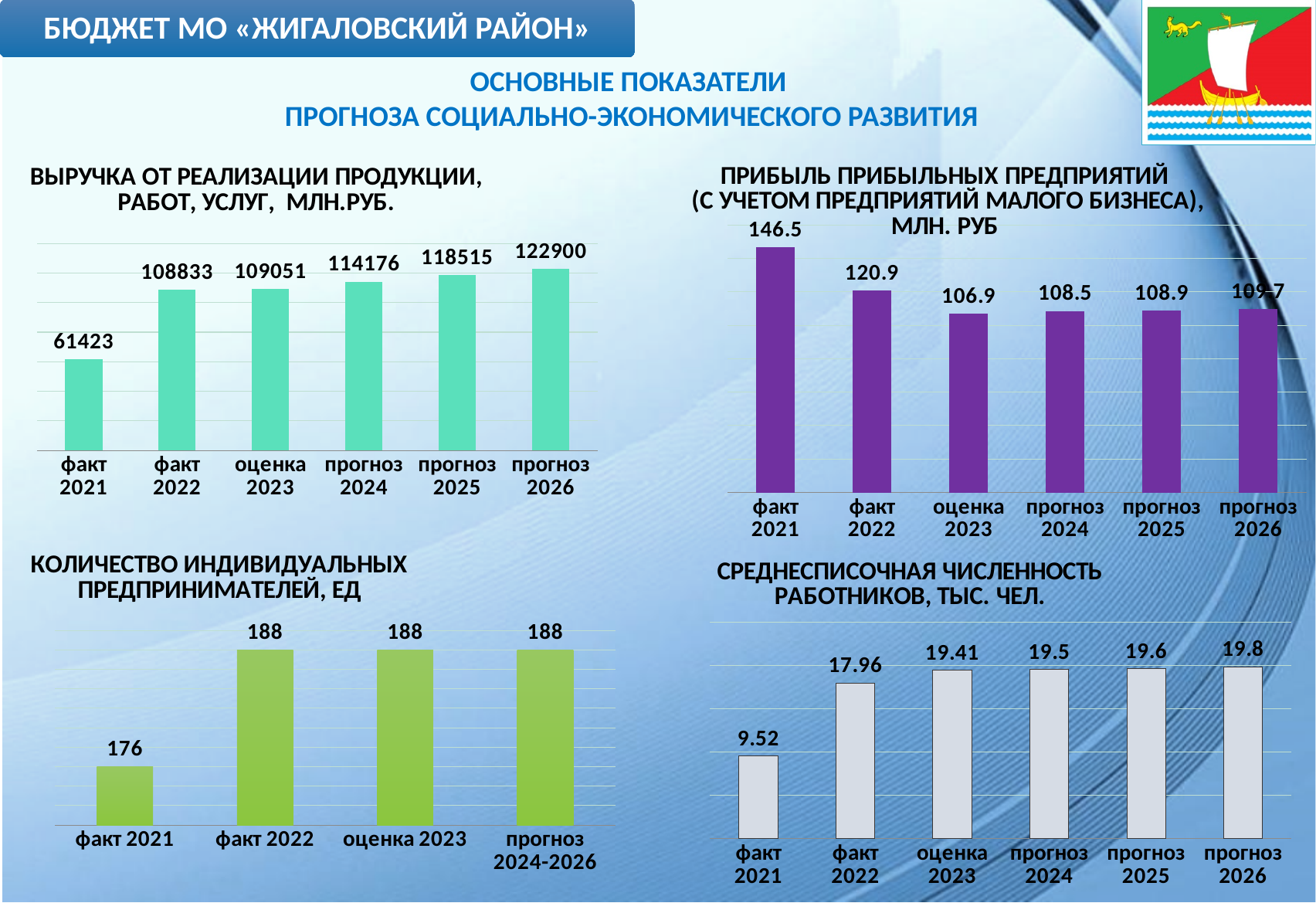
In the top-left chart (ВЫРУЧКА ОТ РЕАЛИЗАЦИИ ПРОДУКЦИИ, РАБОТ, УСЛУГ), what is the difference between прогноз 2026 and прогноз 2025? 4385 In the top-left chart (ВЫРУЧКА ОТ РЕАЛИЗАЦИИ ПРОДУКЦИИ, РАБОТ, УСЛУГ), do the values rise or fall from факт 2021 to прогноз 2026? rise How many categories are shown in the bottom-left chart (КОЛИЧЕСТВО ИНДИВИДУАЛЬНЫХ ПРЕДПРИНИМАТЕЛЕЙ)? 4 In the bottom-right chart (СРЕДНЕСПИСОЧНАЯ ЧИСЛЕННОСТЬ РАБОТНИКОВ), what is the value for оценка 2023? 19.41 In the bottom-left chart (КОЛИЧЕСТВО ИНДИВИДУАЛЬНЫХ ПРЕДПРИНИМАТЕЛЕЙ), what is the value for факт 2021? 176 What type of chart is the bottom-right chart (СРЕДНЕСПИСОЧНАЯ ЧИСЛЕННОСТЬ РАБОТНИКОВ)? bar chart In the top-left chart (ВЫРУЧКА ОТ РЕАЛИЗАЦИИ ПРОДУКЦИИ, РАБОТ, УСЛУГ), what is the value for факт 2021? 61423 In the top-left chart (ВЫРУЧКА ОТ РЕАЛИЗАЦИИ ПРОДУКЦИИ, РАБОТ, УСЛУГ), which category has the highest value? прогноз 2026 In the top-right chart (ПРИБЫЛЬ ПРИБЫЛЬНЫХ ПРЕДПРИЯТИЙ), which category has the lowest value? оценка 2023 In the bottom-right chart (СРЕДНЕСПИСОЧНАЯ ЧИСЛЕННОСТЬ РАБОТНИКОВ), which is larger: факт 2021 or факт 2022? факт 2022 In the top-right chart (ПРИБЫЛЬ ПРИБЫЛЬНЫХ ПРЕДПРИЯТИЙ), what is the difference between факт 2021 and факт 2022? 25.6 In the top-right chart (ПРИБЫЛЬ ПРИБЫЛЬНЫХ ПРЕДПРИЯТИЙ), what is the value for факт 2022? 120.9